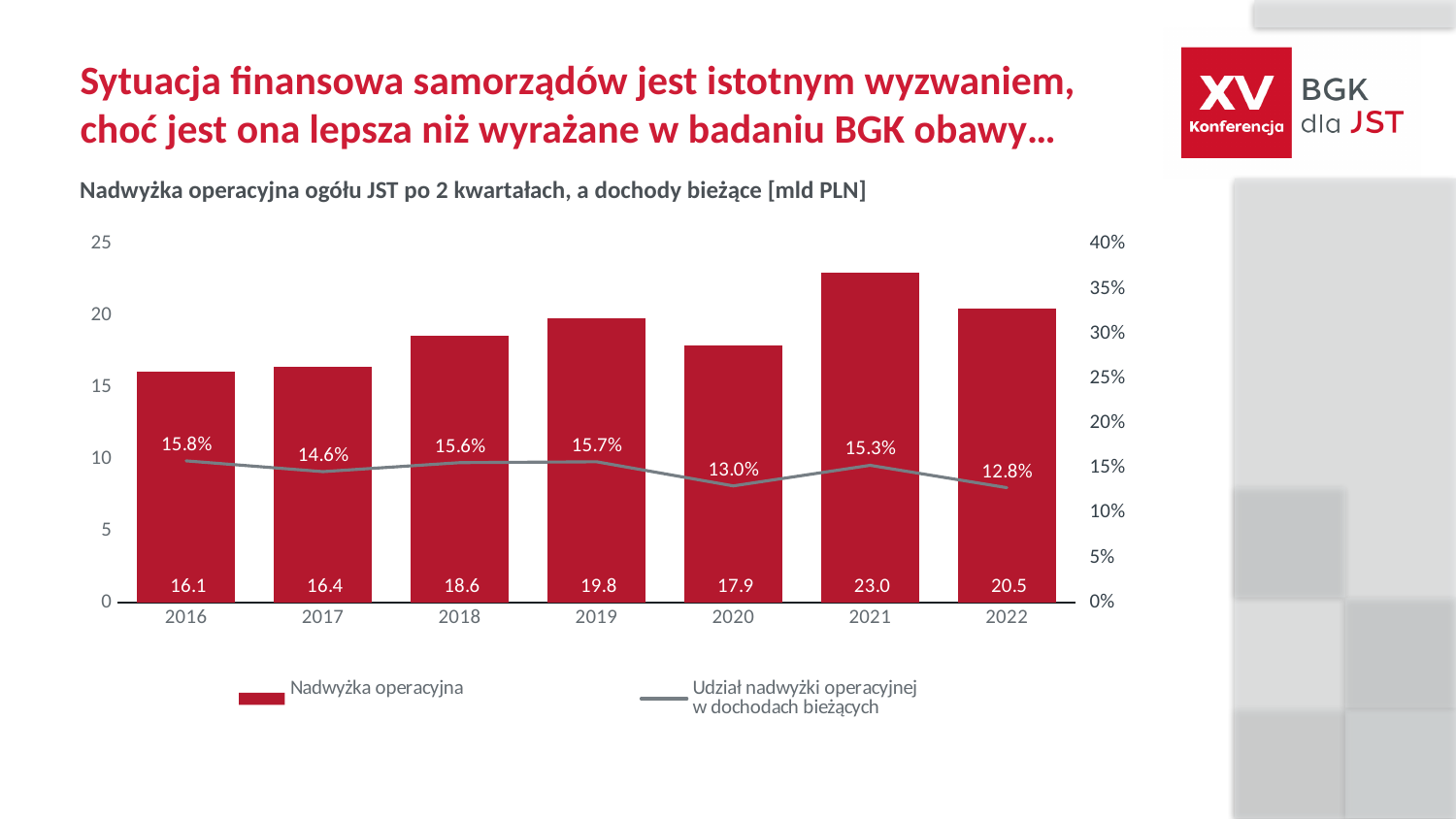
Is the Nadwyżka operacyjna for 2017 greater or less than 15? greater Which year has the lowest Nadwyżka operacyjna? 2016 What is the value of Nadwyżka operacyjna for 2019? 19.8 Which year has the lowest Udział nadwyżki operacyjnej w dochodach bieżących? 2022 What kind of chart is shown on the slide? Combined bar and line chart How many years are shown on the x axis? 7 How many series does the legend list? 2 What is the title of the chart? Nadwyżka operacyjna ogółu JST po 2 kwartałach, a dochody bieżące [mld PLN] Which is larger, the Nadwyżka operacyjna for 2018 or for 2022? 2022 What is the Udział nadwyżki operacyjnej w dochodach bieżących for 2020? 13.0% Which year has the highest Nadwyżka operacyjna? 2021 What is the difference in Nadwyżka operacyjna between 2021 and 2020? 5.1